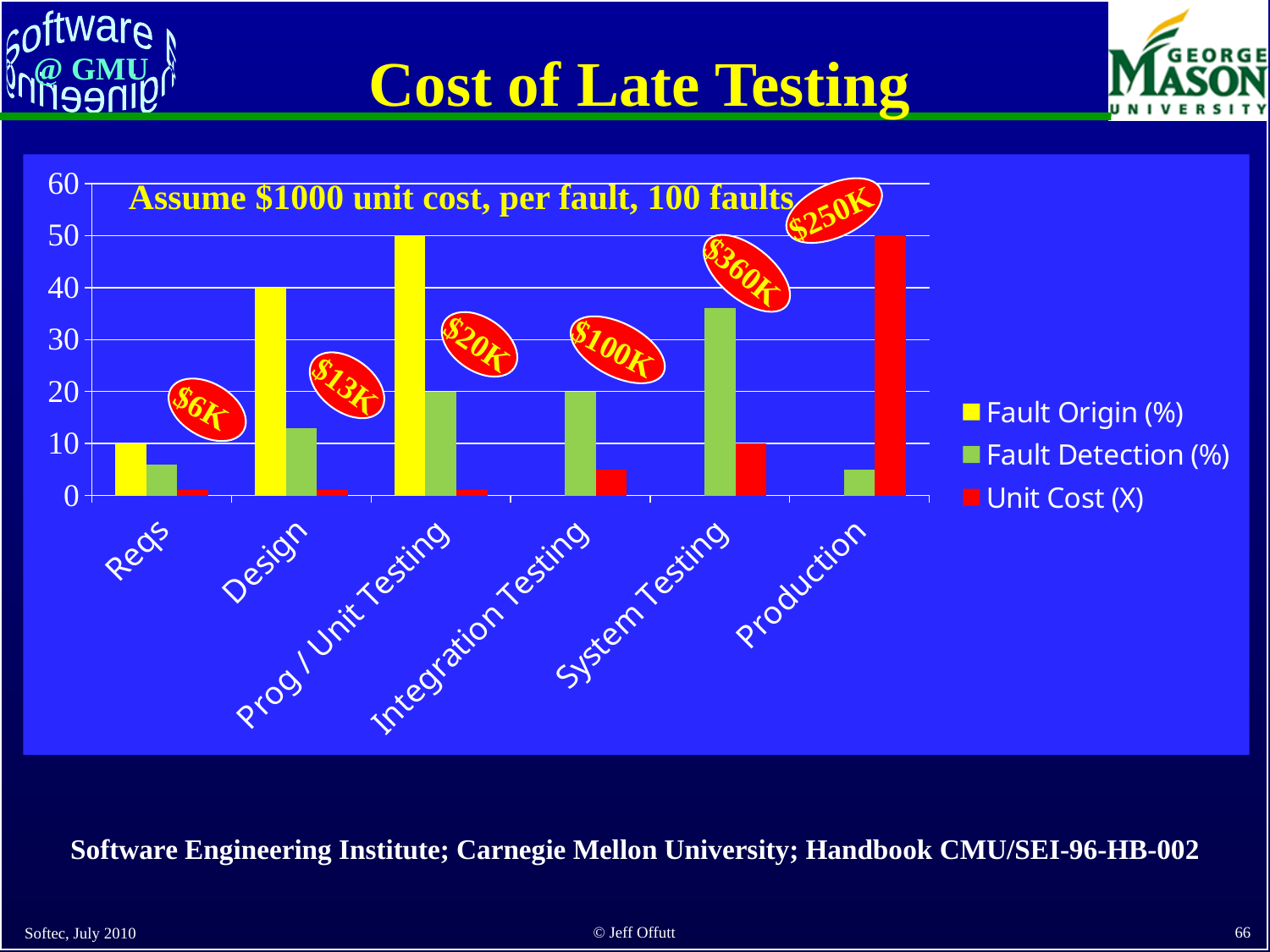
Is the Fault Detection (%) value for Design greater or less than 20? less Which is larger, the Fault Detection (%) value for System Testing or for Integration Testing? System Testing What kind of chart is shown on the slide? bar chart What is the Unit Cost (X) value for System Testing? 10 What is the Unit Cost (X) value for Production? 50 How many series does the legend list? 3 What is the Fault Origin (%) value for Prog / Unit Testing? 50 What is the difference between the Fault Origin (%) values for Prog / Unit Testing and Design? 10 Which category has the highest Unit Cost (X) value? Production What is the Fault Origin (%) value for Design? 40 How many categories are shown on the x axis? 6 Which category has the highest Fault Detection (%) value? System Testing